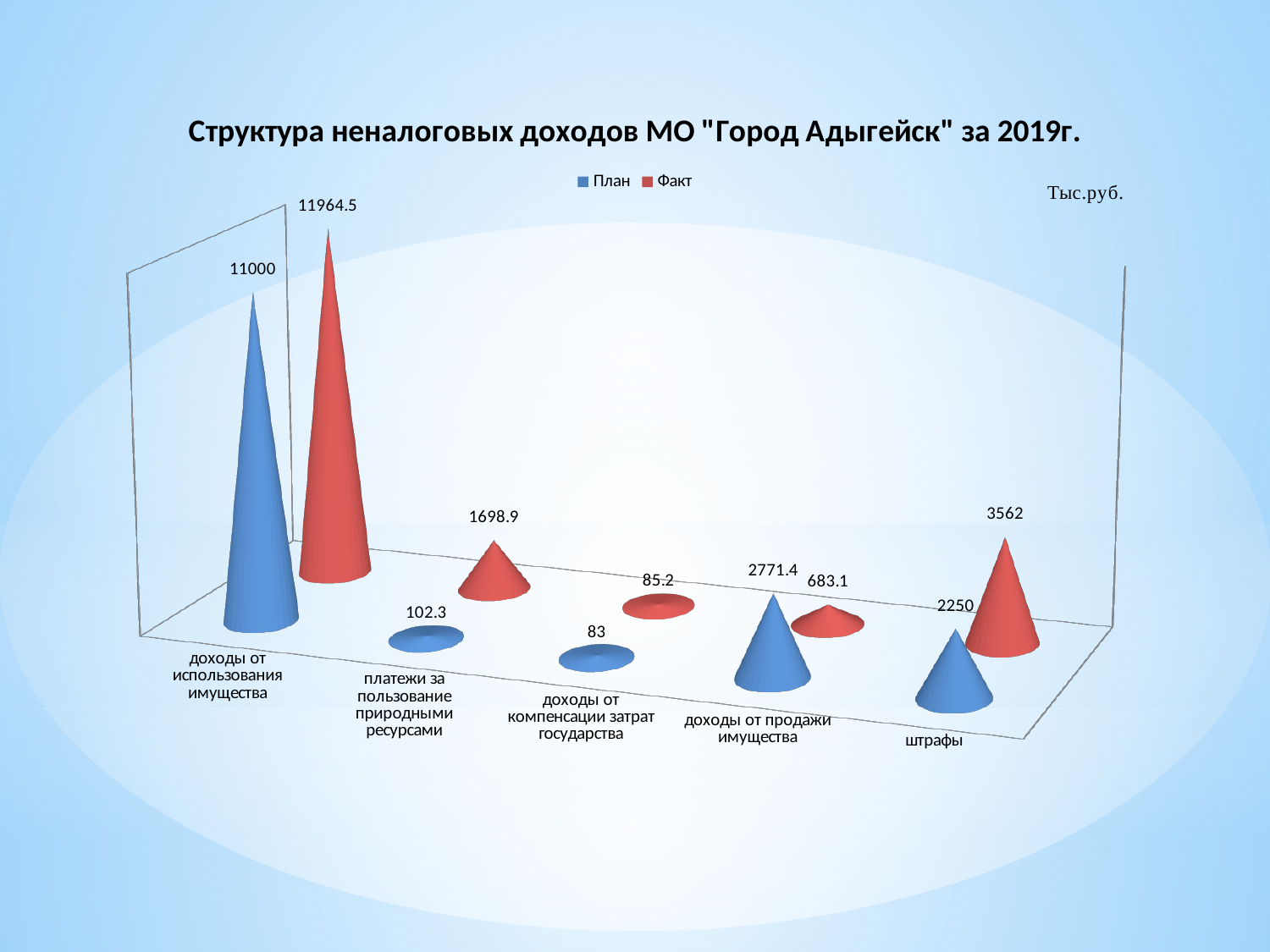
For доходы от продажи имущества, which is larger: План or Факт? План What is the План value for доходы от использования имущества? 11000 What is the Факт value for штрафы? 3562 What is the difference between the Факт and План values for штрафы? 1312 How many series does the legend list? 2 How many categories are shown on the x axis? 5 Which category has the lowest План value? доходы от компенсации затрат государства Which category has the highest Факт value? доходы от использования имущества What is the План value for доходы от продажи имущества? 2771.4 What is the Факт value for доходы от использования имущества? 11964.5 What unit is indicated for the values on the chart? Тыс.руб. What is the Факт value for платежи за пользование природными ресурсами? 1698.9